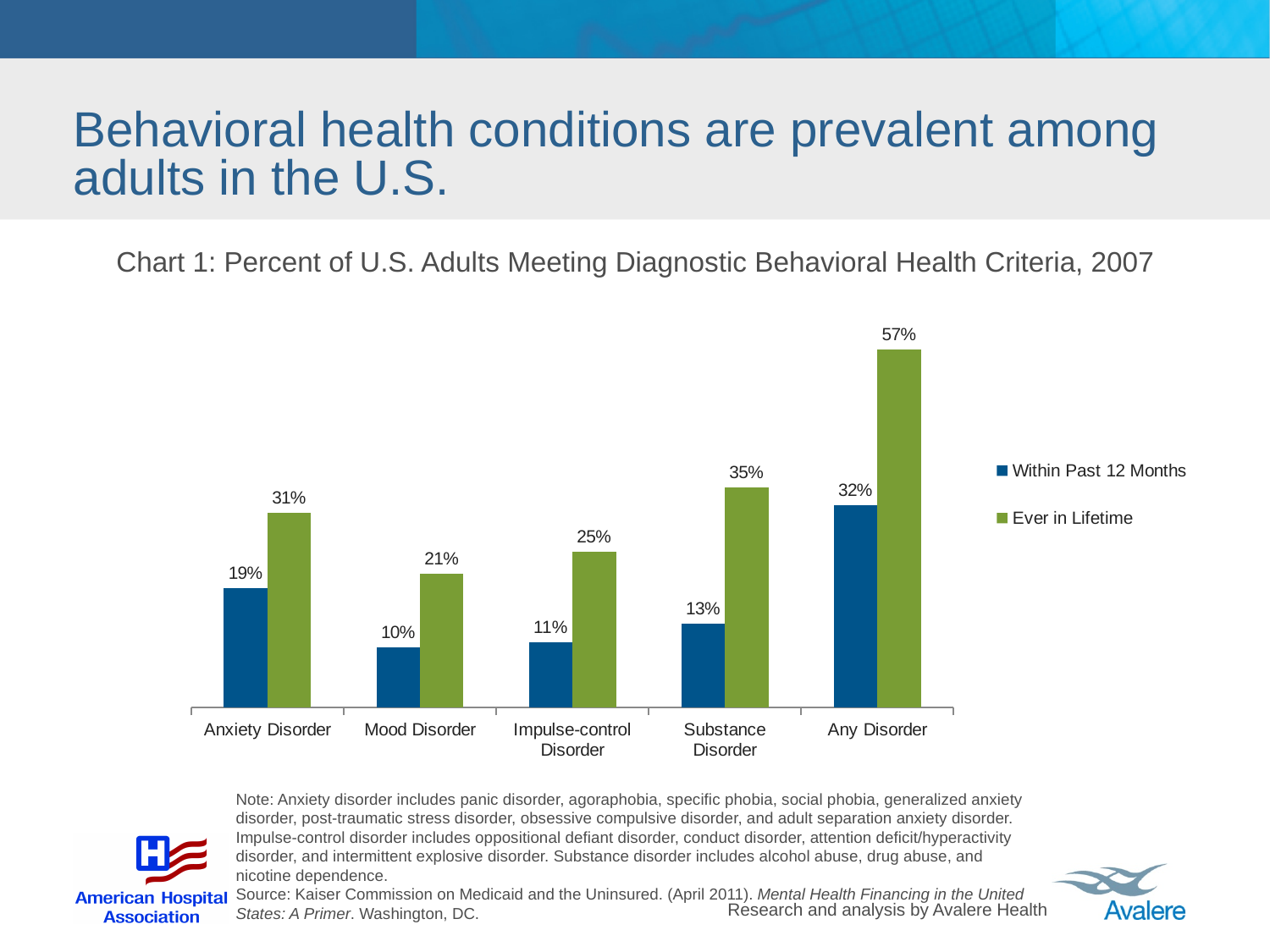
What is the 'Ever in Lifetime' value for Mood Disorder? 21% How many categories are shown on the x axis? 5 What is the title of the chart? Chart 1: Percent of U.S. Adults Meeting Diagnostic Behavioral Health Criteria, 2007 How many series does the legend list? 2 Which category has the highest 'Ever in Lifetime' value? Any Disorder What kind of chart is shown? Bar chart Which is larger: the 'Within Past 12 Months' value for Anxiety Disorder or for Substance Disorder? Anxiety Disorder What is the 'Within Past 12 Months' value for Anxiety Disorder? 19% Which category has the lowest 'Within Past 12 Months' value? Mood Disorder What is the difference between the 'Ever in Lifetime' and 'Within Past 12 Months' values for Any Disorder? 25% Which series is shown in green? Ever in Lifetime What is the 'Ever in Lifetime' value for Substance Disorder? 35%